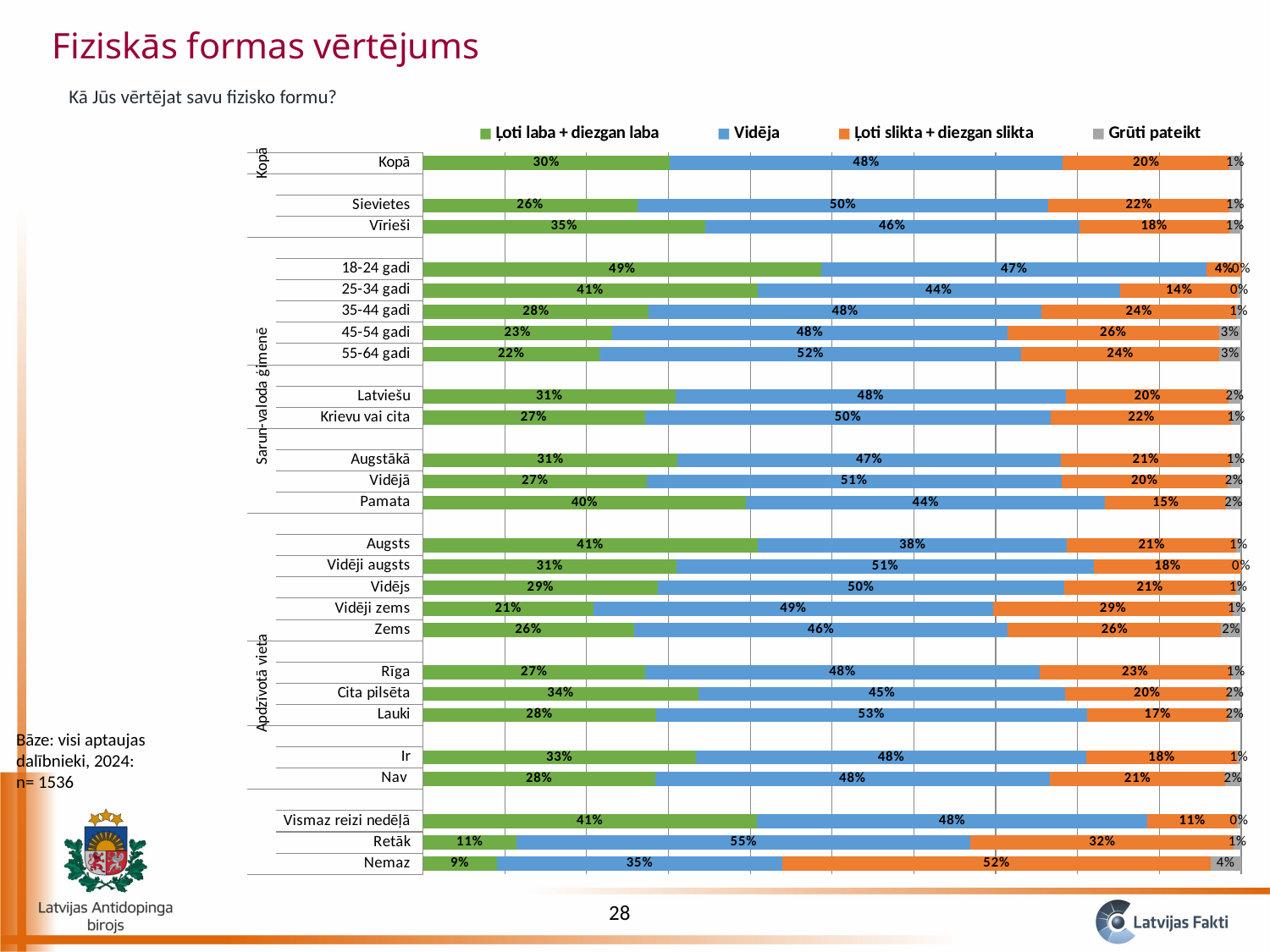
What is the difference between the "Ļoti laba + diezgan laba" values for Vīrieši and Sievietes? 9% Which has a larger "Ļoti slikta + diezgan slikta" value, Vidēji zems or Augsts? Vidēji zems What is the title of the slide? Fiziskās formas vērtējums Which category has the lowest value for "Ļoti laba + diezgan laba"? Nemaz What is the value of "Ļoti laba + diezgan laba" for Kopā? 30% What kind of chart is shown on the slide? stacked bar chart What is the value of "Vidēja" for Retāk? 55% What is the value of "Ļoti slikta + diezgan slikta" for Nemaz? 52% What is the value of "Grūti pateikt" for 45-54 gadi? 3% Which category has the highest value for "Ļoti laba + diezgan laba"? 18-24 gadi How many series does the legend list? 4 What is the difference between the "Vidēja" values for Lauki and Cita pilsēta? 8%